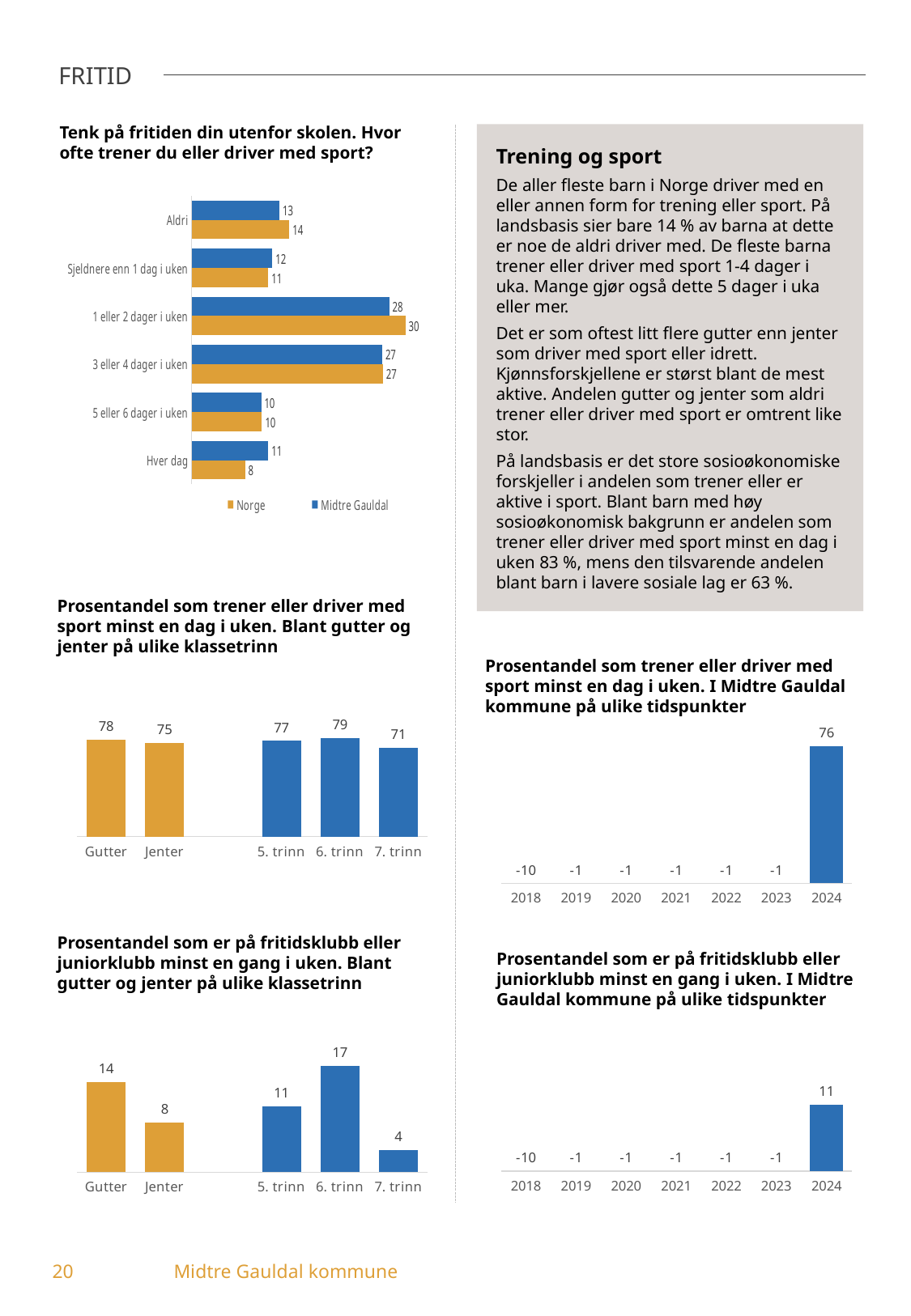
In the chart 'Prosentandel som er på fritidsklubb eller juniorklubb minst en gang i uken. Blant gutter og jenter på ulike klassetrinn', which is larger, Gutter or Jenter? Gutter What type of chart is 'Tenk på fritiden din utenfor skolen. Hvor ofte trener du eller driver med sport?'? Bar chart In the chart 'Tenk på fritiden din utenfor skolen. Hvor ofte trener du eller driver med sport?', how many series does the legend list? 2 In the chart 'Prosentandel som trener eller driver med sport minst en dag i uken. I Midtre Gauldal kommune på ulike tidspunkter', what is the value for 2024? 76 In the chart 'Tenk på fritiden din utenfor skolen. Hvor ofte trener du eller driver med sport?', what is the value for Norge in the category 'Hver dag'? 8 In the chart 'Tenk på fritiden din utenfor skolen. Hvor ofte trener du eller driver med sport?', what is the value for Midtre Gauldal in the category '1 eller 2 dager i uken'? 28 In the chart 'Prosentandel som trener eller driver med sport minst en dag i uken. Blant gutter og jenter på ulike klassetrinn', what is the value for 6. trinn? 79 In the chart 'Tenk på fritiden din utenfor skolen. Hvor ofte trener du eller driver med sport?', which category has the highest value for Norge? 1 eller 2 dager i uken In the chart 'Tenk på fritiden din utenfor skolen. Hvor ofte trener du eller driver med sport?', what is the difference between Norge and Midtre Gauldal for 'Aldri'? 1 In the chart 'Prosentandel som trener eller driver med sport minst en dag i uken. Blant gutter og jenter på ulike klassetrinn', which category has the lowest value? 7. trinn In the chart 'Prosentandel som er på fritidsklubb eller juniorklubb minst en gang i uken. I Midtre Gauldal kommune på ulike tidspunkter', what is the value for 2024? 11 In the chart 'Prosentandel som er på fritidsklubb eller juniorklubb minst en gang i uken. Blant gutter og jenter på ulike klassetrinn', what is the difference between 6. trinn and 7. trinn? 13